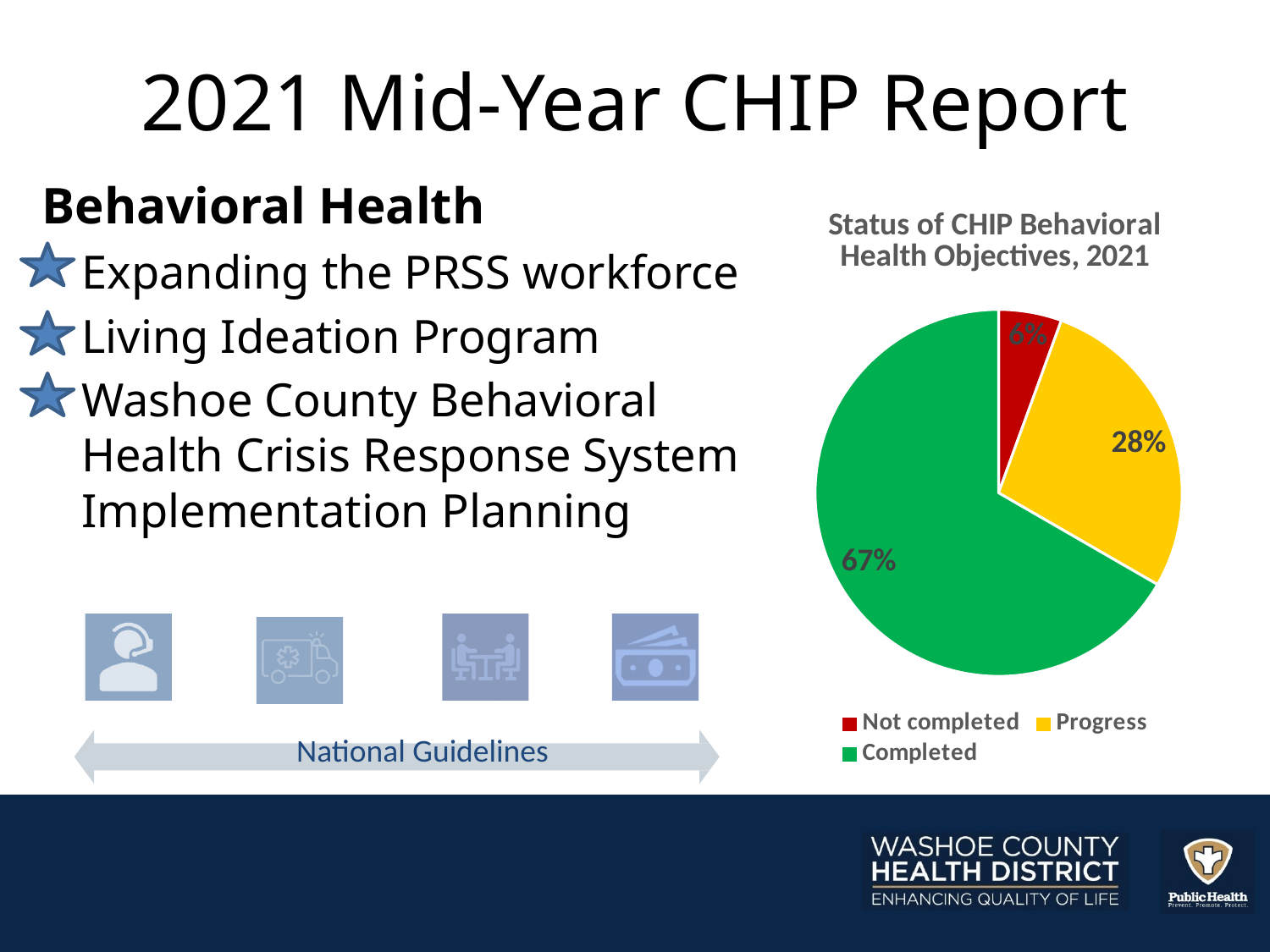
Which is larger, the Progress slice or the Not completed slice? Progress What percentage of CHIP Behavioral Health objectives are Completed? 67% What percentage of CHIP Behavioral Health objectives are Not completed? 6% What is the difference in percentage points between the Completed and Progress slices? 39 Which category has the largest share of the pie? Completed How many categories does the legend list? 3 What colour represents the Completed category in the chart? green What percentage of CHIP Behavioral Health objectives are in Progress? 28% Which category has the smallest share of the pie? Not completed How many slices does the pie chart have? 3 What type of chart is shown on the slide? pie chart What is the title of the chart? Status of CHIP Behavioral Health Objectives, 2021